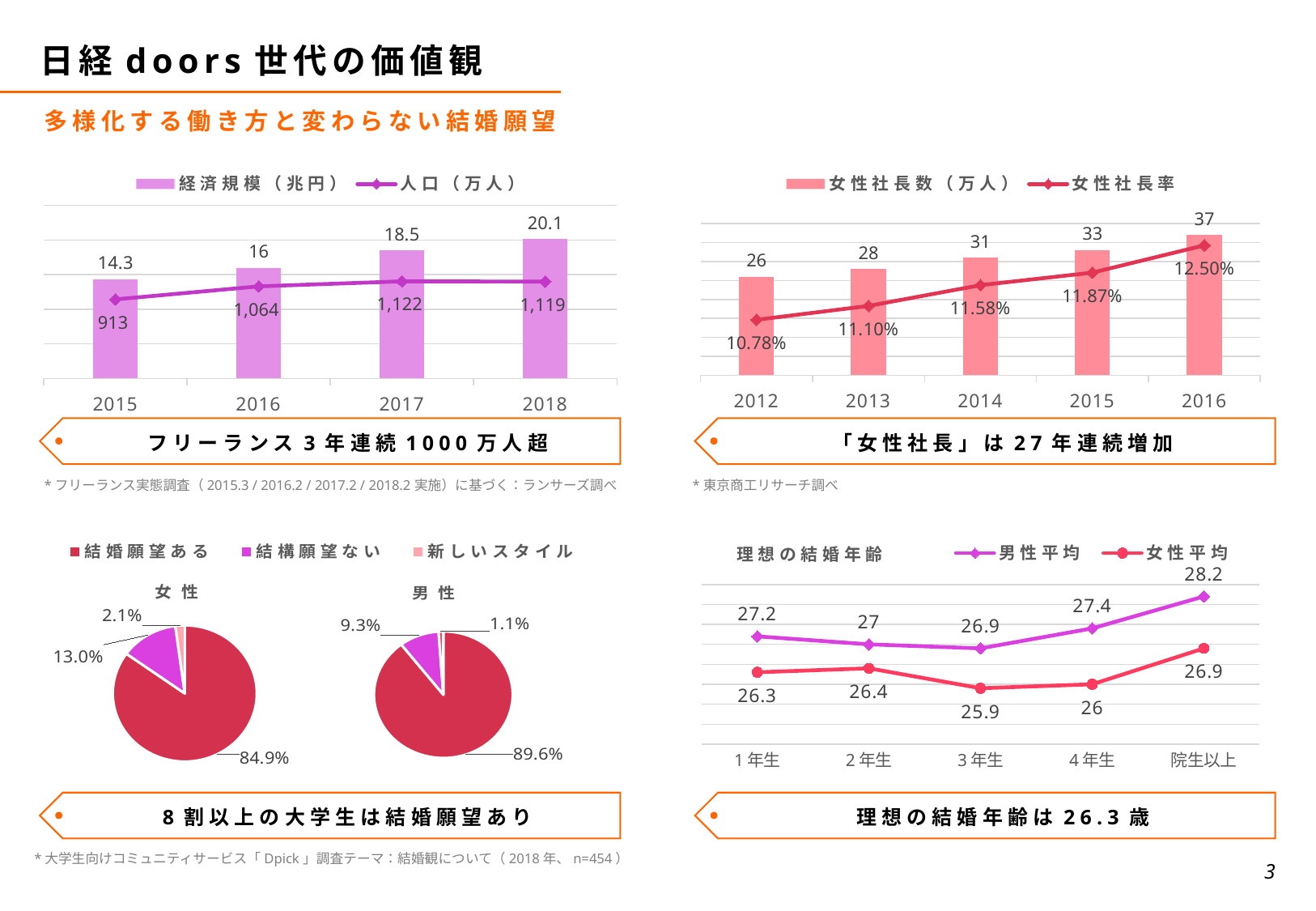
In the top-right chart, how many years are shown on the x axis? 5 In the top-left chart, what is the value of 人口（万人） for 2016? 1,064 In the top-left chart, what is the difference in 経済規模（兆円） between 2018 and 2015? 5.8 In the top-right chart, does 女性社長率 rise or fall from 2012 to 2016? rise In the bottom-right 理想の結婚年齢 chart, which category has the highest 男性平均 value? 院生以上 In the top-right chart, what is the 女性社長数（万人） for 2016? 37 In the top-right chart, what is the 女性社長率 for 2014? 11.58% In the top-left chart, which year has the highest 人口（万人） value? 2017 In the bottom-right 理想の結婚年齢 chart, what is the 女性平均 value for 3年生? 25.9 In the bottom-left 男性 pie chart, what share is 結構願望ない? 9.3% In the bottom-left 女性 pie chart, what share is 結婚願望ある? 84.9% In the top-left chart, what is the value of 経済規模（兆円） for 2018? 20.1